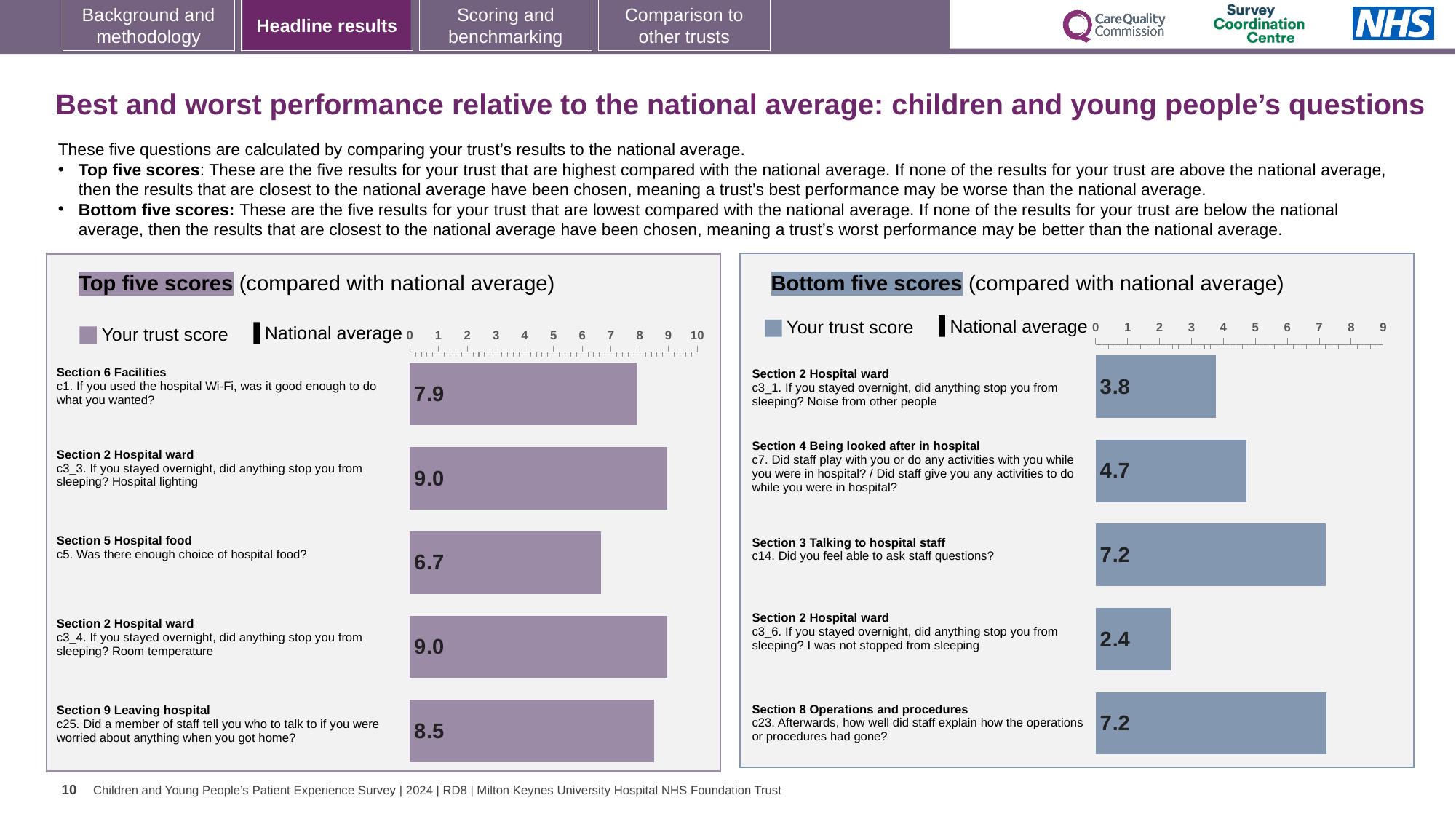
In the Bottom five scores chart, what is the trust score for c7 (staff play with you or do activities)? 4.7 In the Bottom five scores chart, which question has the lowest trust score? c3_6. I was not stopped from sleeping In the Top five scores chart, what is the trust score for c1 (hospital Wi-Fi good enough)? 7.9 In the Top five scores chart, what is the trust score for c5 (enough choice of hospital food)? 6.7 In the Top five scores chart, what is the difference between the trust scores for c3_3 (hospital lighting) and c5 (hospital food choice)? 2.3 In the Bottom five scores chart, what is the difference between the trust scores for c14 (able to ask staff questions) and c3_6 (not stopped from sleeping)? 4.8 In the Top five scores chart, which has the higher trust score: c25 (who to talk to when worried at home) or c1 (hospital Wi-Fi)? c25 How many series does the legend of the Top five scores chart list? 2 What type of chart is the Bottom five scores chart? Bar chart How many questions are shown in the Bottom five scores chart? 5 In the Top five scores chart, which question has the lowest trust score? c5. Was there enough choice of hospital food? In the Bottom five scores chart, what is the trust score for c3_1 (noise from other people)? 3.8